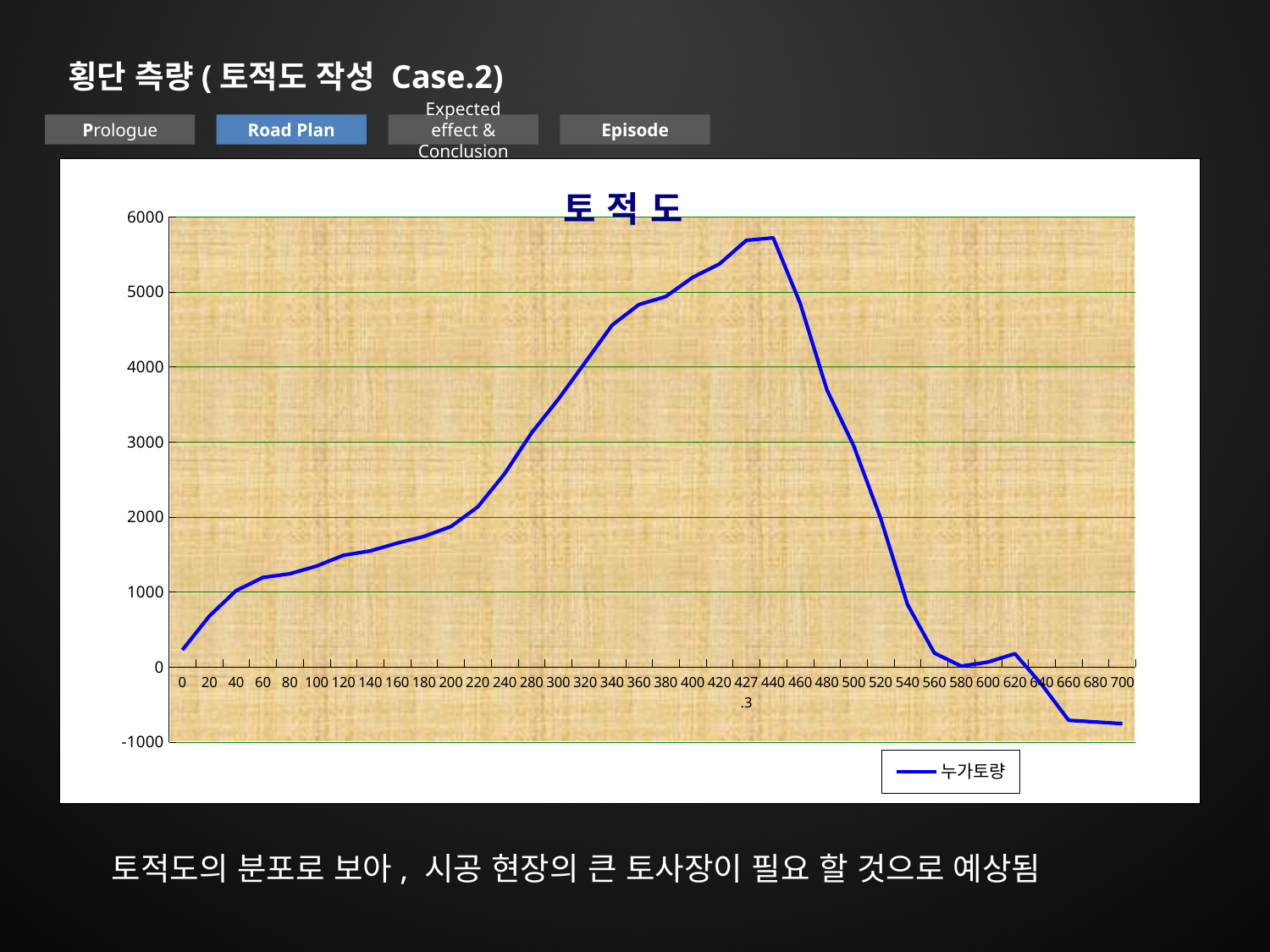
What kind of chart is shown on the slide? line chart How many series does the legend list? 1 What is the title of the chart? 토 적 도 What is the name of the series shown in the legend? 누가토량 Is the value for 누가토량 at x = 660 greater or less than 0? less Does the 누가토량 line rise or fall between x = 440 and x = 700? fall Is the value for 누가토량 at x = 200 greater or less than 2000? less Is the value for 누가토량 at x = 540 greater or less than 1000? less Which has the larger 누가토량 value, x = 340 or x = 200? 340 How many x-axis categories are plotted on the chart? 36